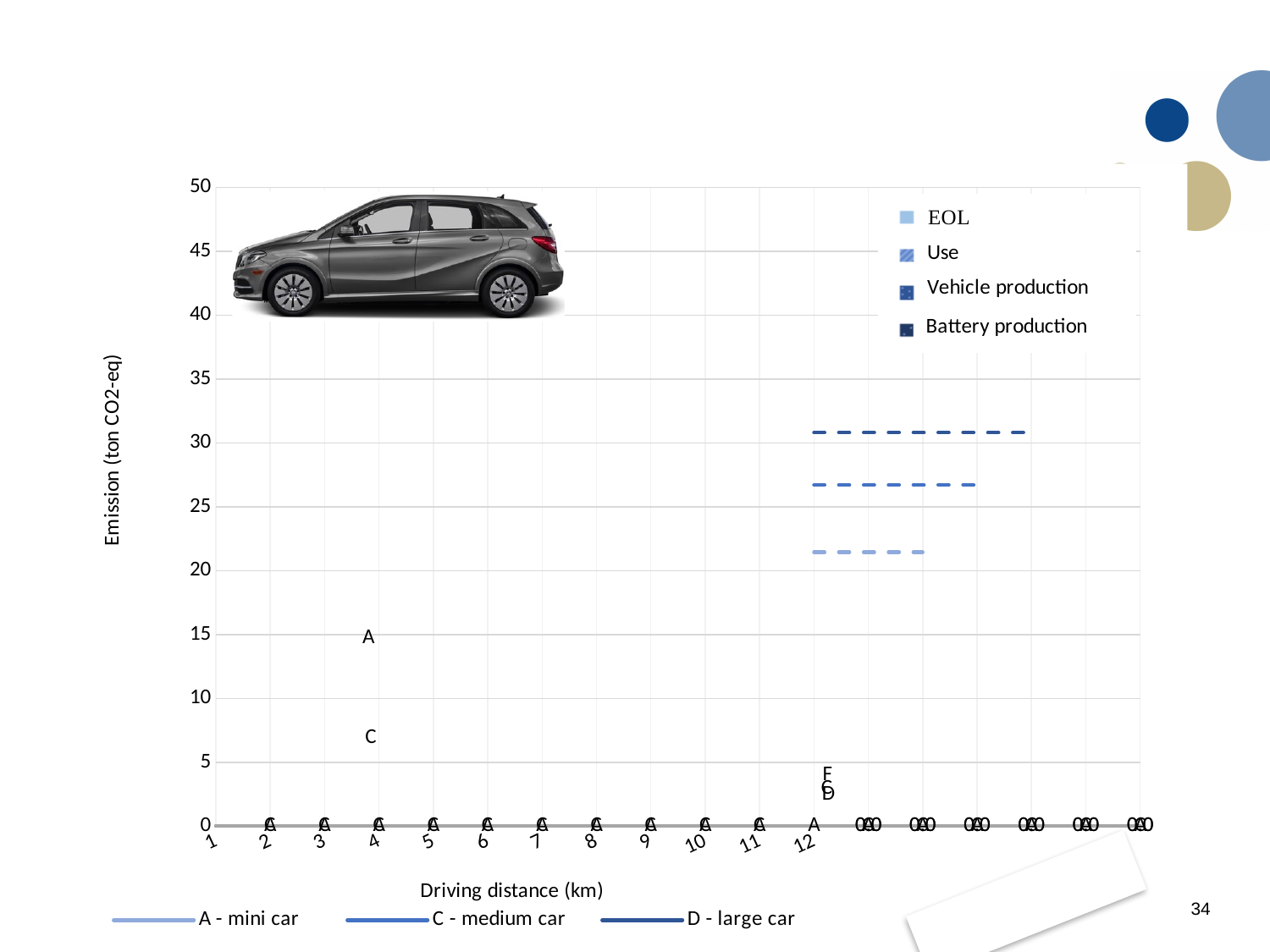
Which vehicle type's dashed line is the highest on the chart? D - large car How many vehicle types does the legend at the bottom of the chart list? 3 Which dashed line is higher on the chart, D - large car or A - mini car? D - large car Is the dashed line for C - medium car greater or less than 25? greater What is the label on the vertical axis of the chart? Emission (ton CO2-eq) What is the highest value shown on the vertical axis of the chart? 50 Is the dashed line for D - large car greater or less than 35? less Is the dashed line for C - medium car greater or less than 30? less Which vehicle type's dashed line is the lowest on the chart? A - mini car How many entries does the legend in the upper right of the chart list? 4 What is the label on the horizontal axis of the chart? Driving distance (km)